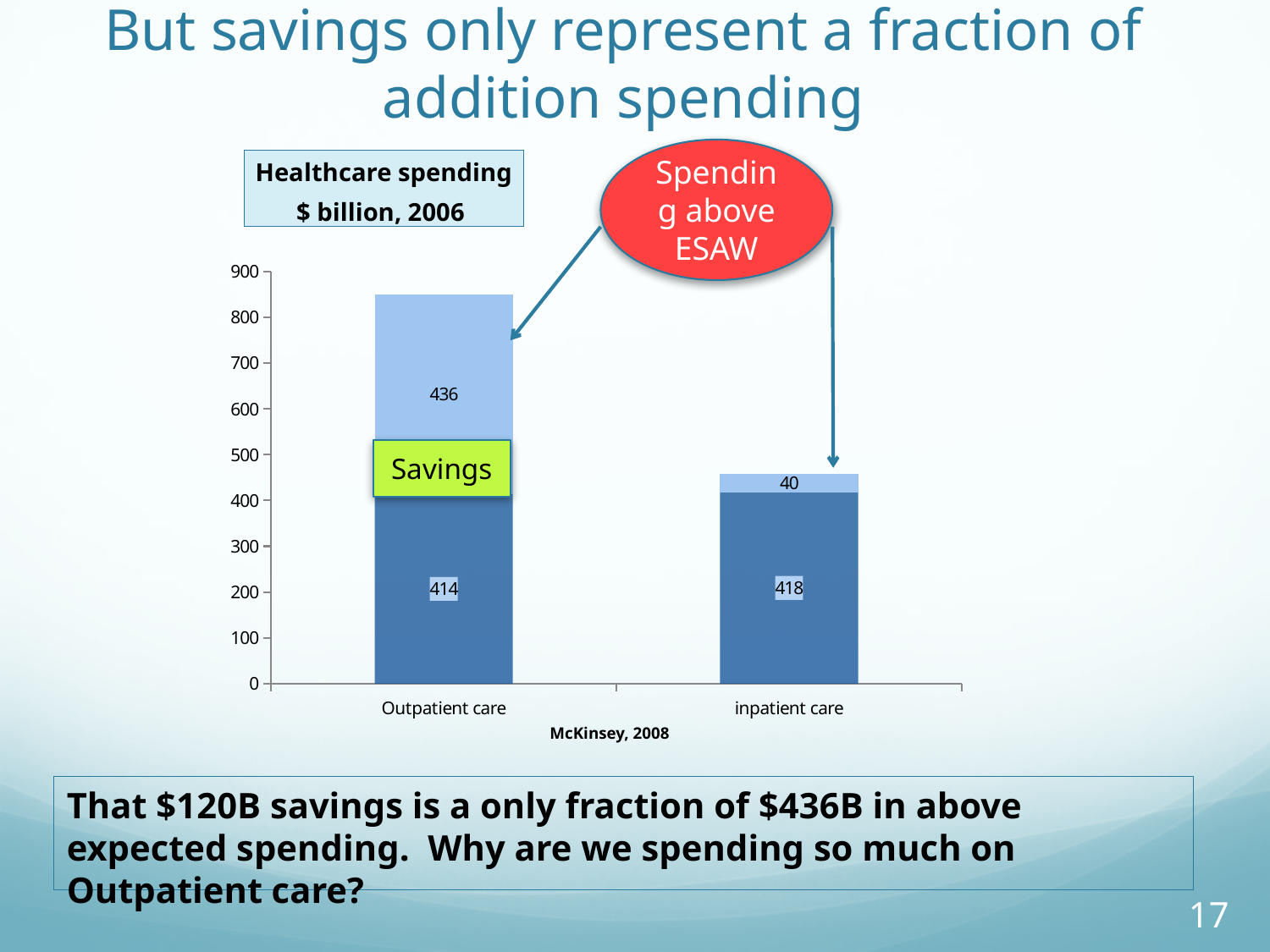
What is the total of the stacked bar for inpatient care? 458 What is the value of the spending above ESAW segment for inpatient care? 40 What is the value of the lower (dark blue) segment for inpatient care? 418 What kind of chart is shown on the slide? Stacked bar chart Is the total height of the inpatient care bar greater or less than 500? less Which category has the larger spending above ESAW segment? Outpatient care What is the total of the stacked bar for Outpatient care? 850 What unit and year does the chart title give for healthcare spending? $ billion, 2006 What is the difference between the spending above ESAW segments for Outpatient care and inpatient care? 396 How many categories are shown on the x axis? 2 What is the value of the lower (dark blue) segment for Outpatient care? 414 What is the value of the spending above ESAW segment for Outpatient care? 436